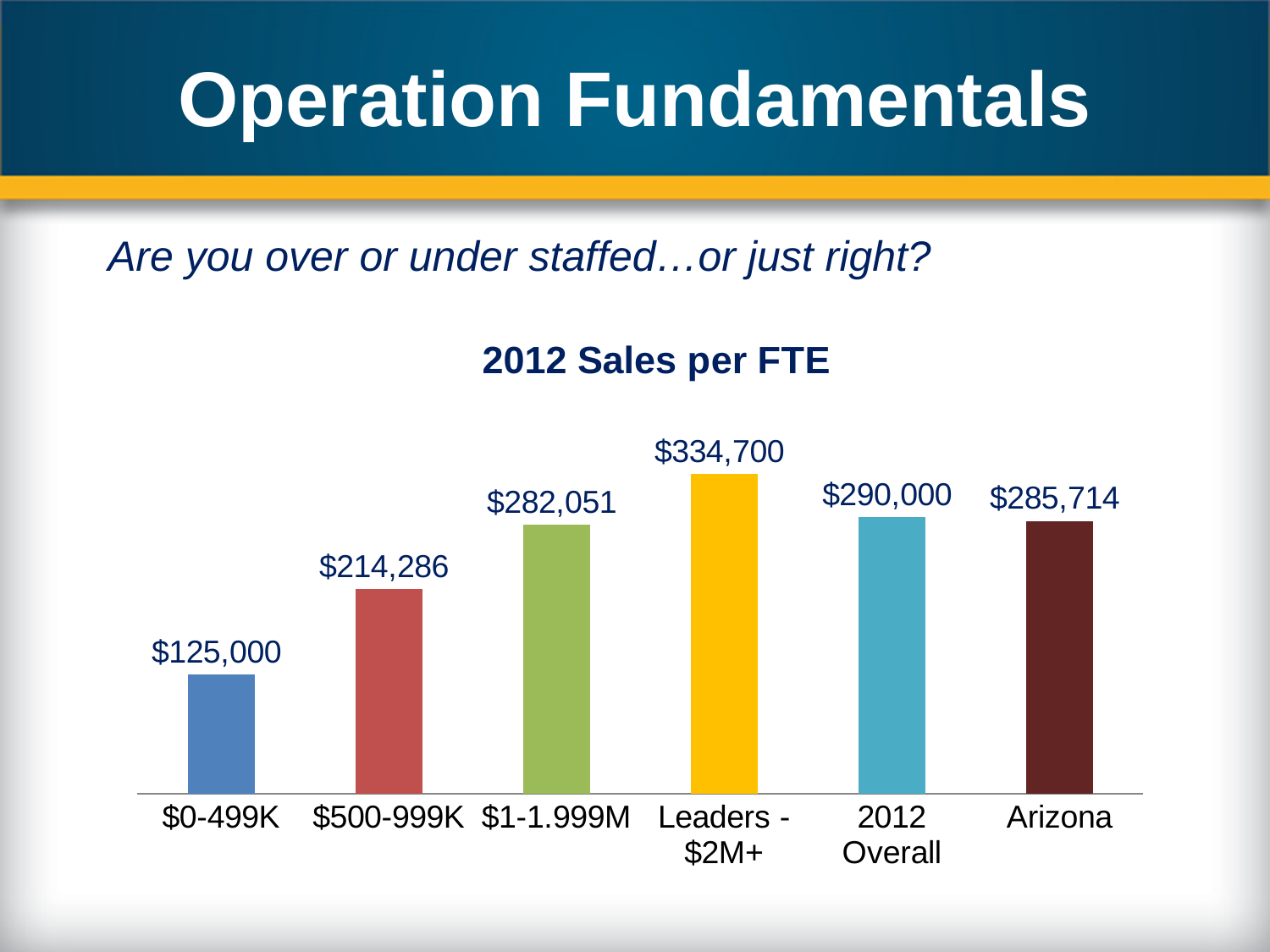
Which is larger, the value for 2012 Overall or the value for Arizona? 2012 Overall What kind of chart is shown on the slide? Bar chart What is the value shown for the $1-1.999M category? $282,051 How many categories are shown on the chart? 6 What is the difference between the Leaders - $2M+ value and the 2012 Overall value? $44,700 What is the difference between the $500-999K value and the $0-499K value? $89,286 Which category has the highest Sales per FTE? Leaders - $2M+ What is the 2012 Sales per FTE value for the $0-499K category? $125,000 What is the title of the chart? 2012 Sales per FTE What is the value shown for Arizona? $285,714 Which is larger, the value for $500-999K or the value for $1-1.999M? $1-1.999M Which category has the lowest Sales per FTE? $0-499K